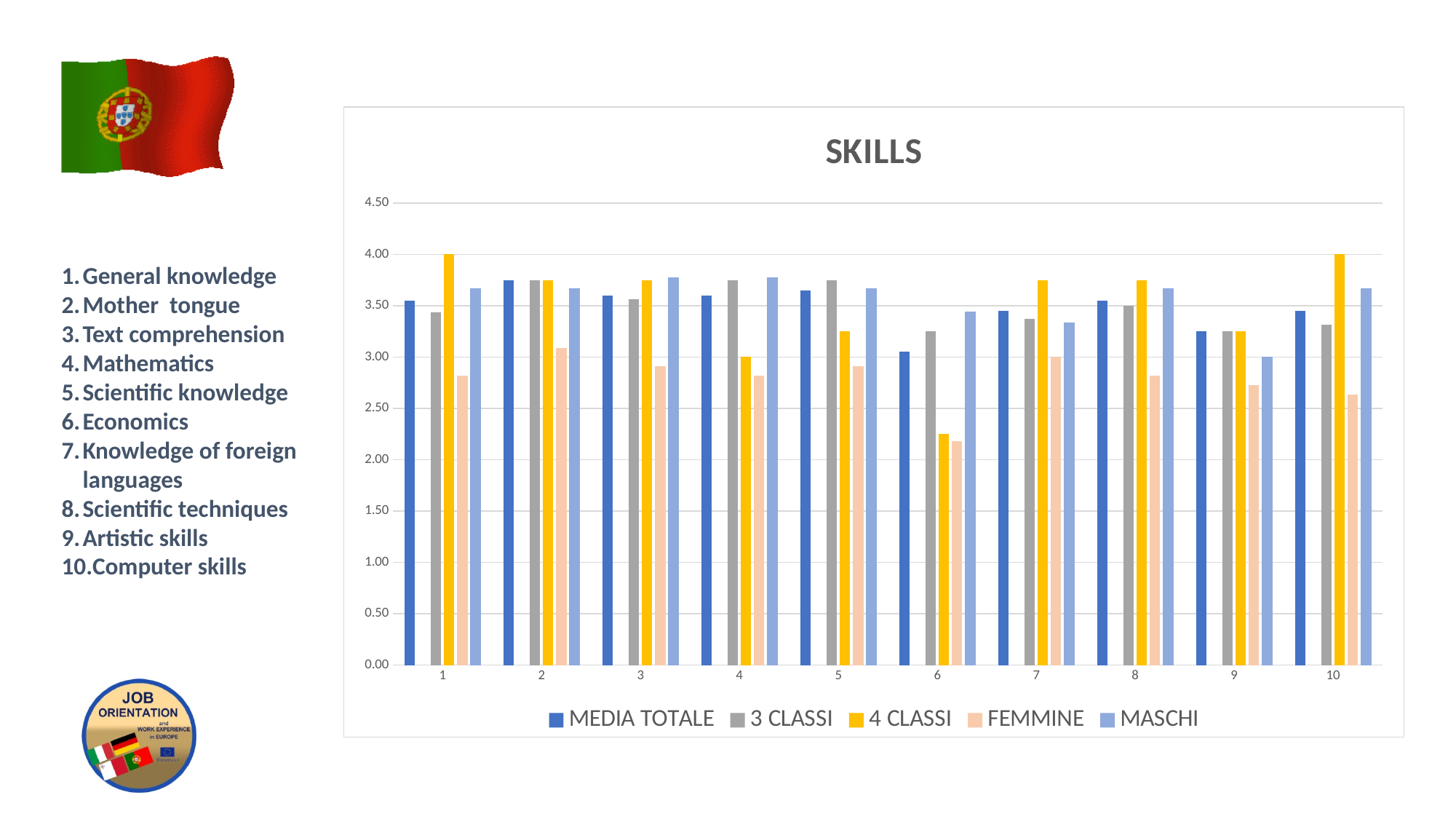
Which colour represents the 4 CLASSI series in the chart? yellow Is the 4 CLASSI value for category 6 greater or less than 2.50? less How many categories are plotted along the x axis of the SKILLS chart? 10 Is the FEMMINE value for category 10 greater or less than 3.00? less At category 1, which is larger: the 4 CLASSI value or the FEMMINE value? 4 CLASSI Is the MASCHI value for category 6 greater or less than 3.00? greater How many series does the legend of the SKILLS chart list? 5 At category 6, which is larger: the 4 CLASSI value or the MASCHI value? MASCHI What kind of chart is shown on the slide? bar chart What is the title of the chart? SKILLS For which category is the 4 CLASSI value lowest? 6